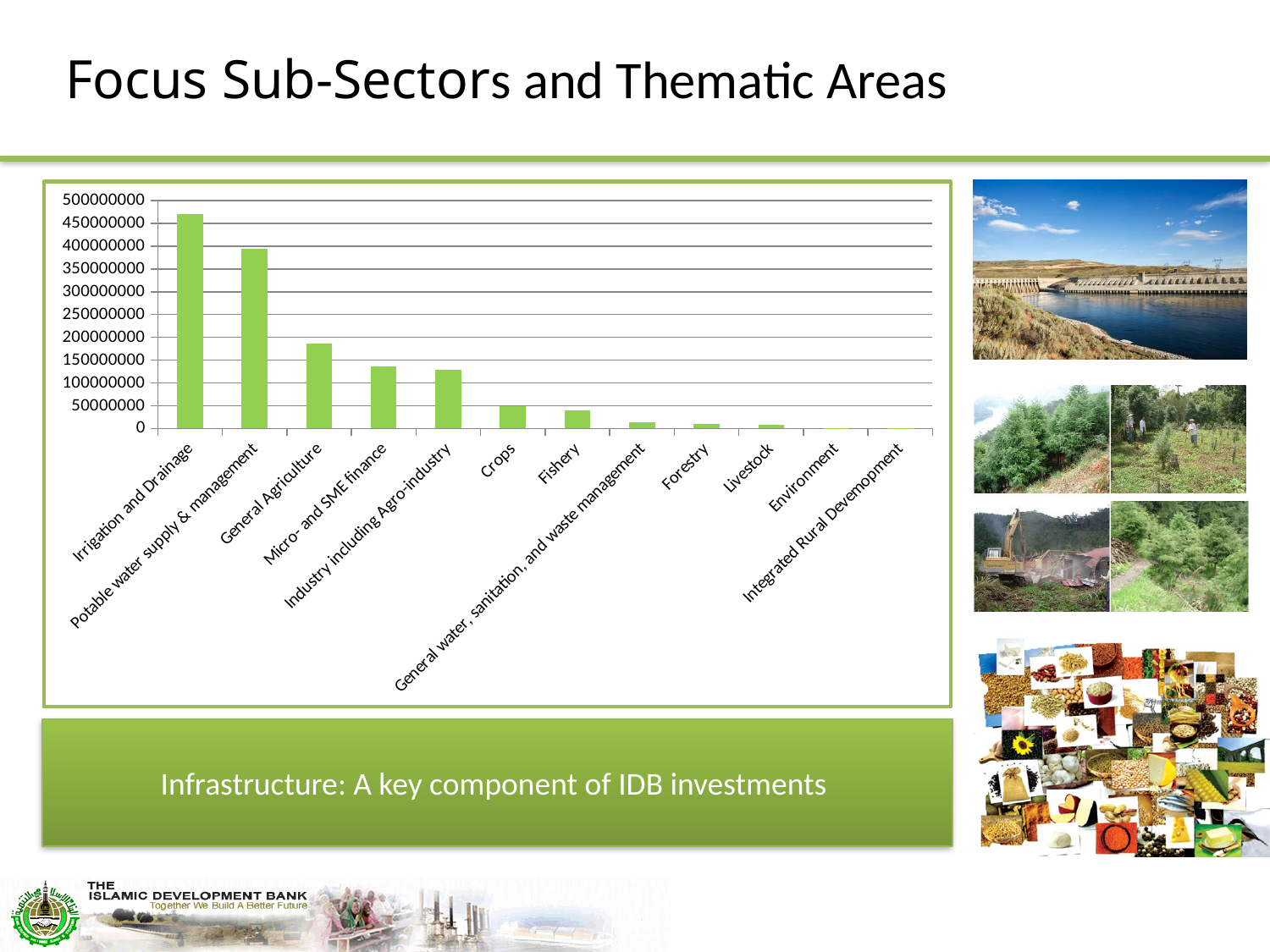
Is the value for Irrigation and Drainage greater or less than 450000000? greater Is the value for Crops greater or less than 100000000? less Do the values generally rise or fall moving from left to right along the x axis? Fall Which is larger, the value for General Agriculture or the value for Micro- and SME finance? General Agriculture Is the value for General Agriculture greater or less than 200000000? less Which is larger, the value for Crops or the value for Forestry? Crops Which category has the highest value in the chart? Irrigation and Drainage How many categories are shown on the x axis of the chart? 12 What kind of chart is shown on the slide? Bar chart What colour are the bars in the chart? Green